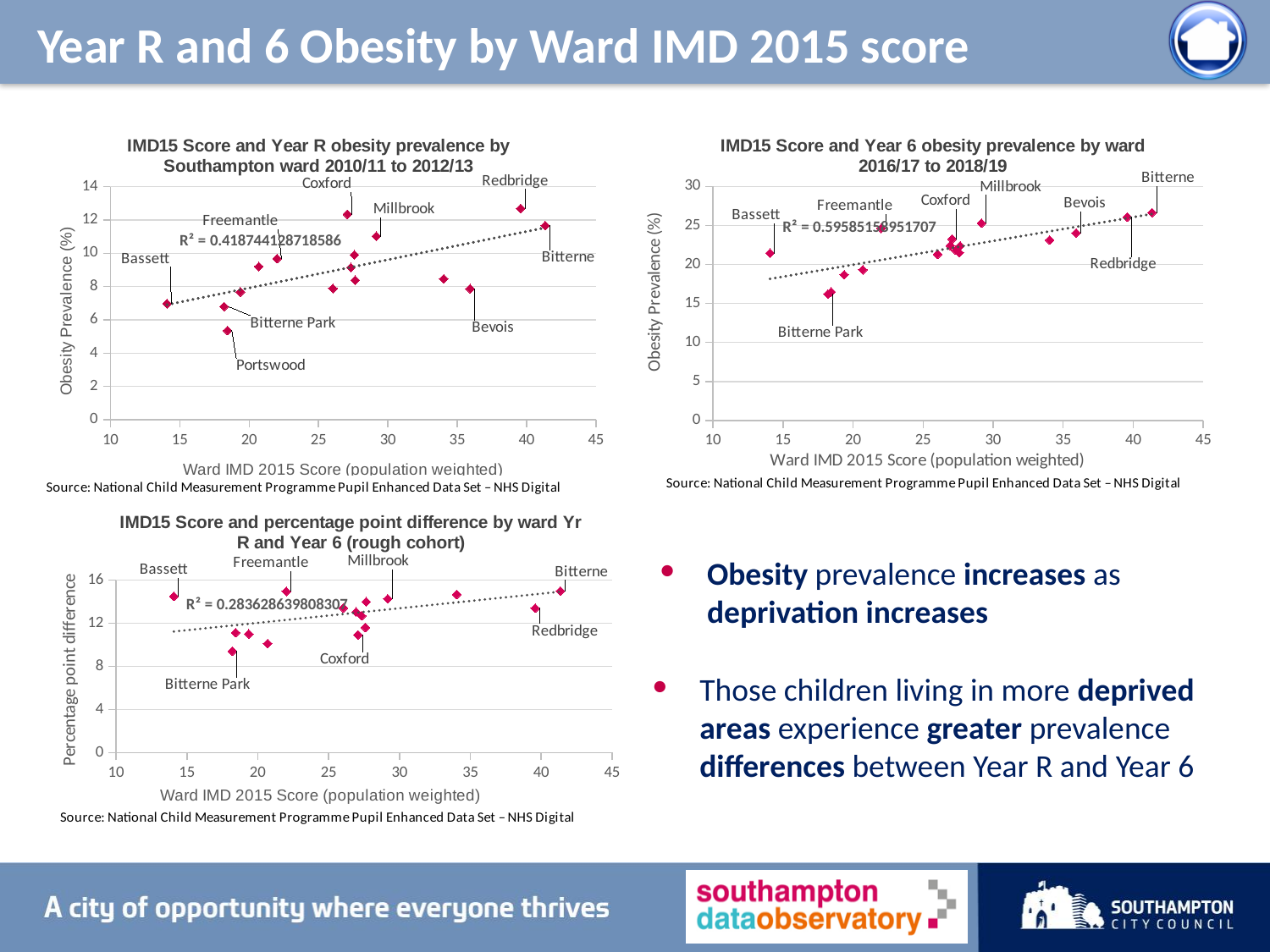
In the 'IMD15 Score and Year 6 obesity prevalence by ward 2016/17 to 2018/19' chart, does the trend line rise or fall as the Ward IMD 2015 Score increases? Rises In the 'IMD15 Score and percentage point difference by ward Yr R and Year 6 (rough cohort)' chart, is the percentage point difference for Bitterne Park greater or less than 12? less What is the x-axis label of the 'IMD15 Score and Year R obesity prevalence by Southampton ward 2010/11 to 2012/13' chart? Ward IMD 2015 Score (population weighted) In the 'IMD15 Score and Year 6 obesity prevalence by ward 2016/17 to 2018/19' chart, is the obesity prevalence for Bitterne Park greater or less than 20? less In the 'IMD15 Score and percentage point difference by ward Yr R and Year 6 (rough cohort)' chart, what R² value is printed? R² = 0.283628639808307 In the 'IMD15 Score and Year R obesity prevalence by Southampton ward 2010/11 to 2012/13' chart, which labelled ward has the lowest obesity prevalence? Portswood In the 'IMD15 Score and Year 6 obesity prevalence by ward 2016/17 to 2018/19' chart, is the obesity prevalence for Bitterne greater or less than 25? greater In the 'IMD15 Score and Year 6 obesity prevalence by ward 2016/17 to 2018/19' chart, which has the higher obesity prevalence, Bitterne or Bitterne Park? Bitterne In the 'IMD15 Score and Year R obesity prevalence by Southampton ward 2010/11 to 2012/13' chart, what R² value is printed? R² = 0.418744128718586 What kind of chart is the 'IMD15 Score and Year R obesity prevalence by Southampton ward 2010/11 to 2012/13' chart? Scatter chart